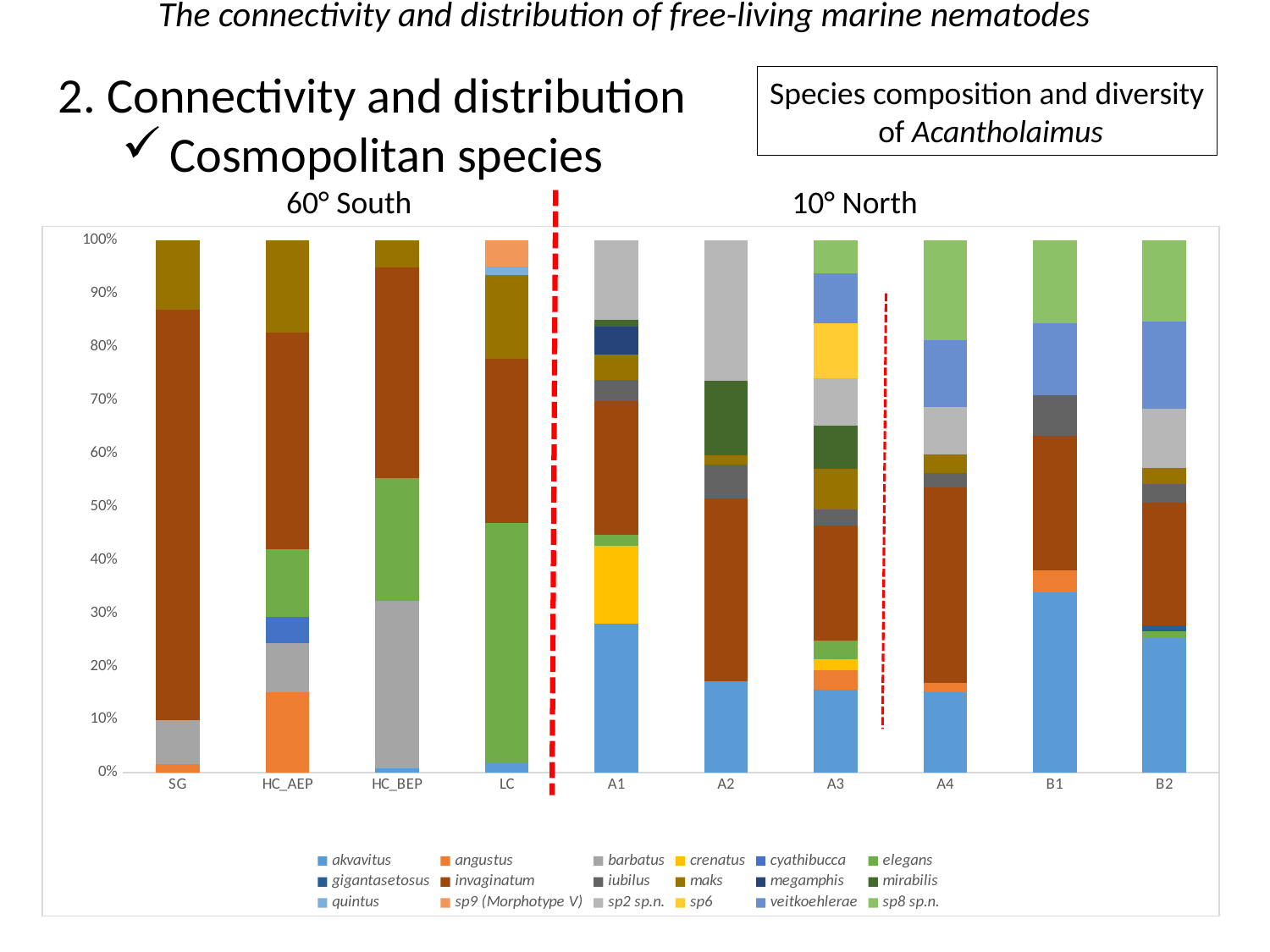
Is the akvavitus share for station A4 greater or less than 20%? less Which station has the largest akvavitus share? B1 How many sampling stations (categories) are shown along the x axis of the chart? 10 Is the akvavitus share for station B1 greater or less than 30%? greater Is the akvavitus share for station B2 greater or less than 20%? greater What is the maximum value shown on the y axis of the chart? 100% How many species (series) does the chart legend list? 18 What kind of chart is shown on the slide? stacked bar chart Which species is listed first in the chart legend? akvavitus Which station has a larger akvavitus share, B1 or A4? B1 Which station has the largest invaginatum share? SG